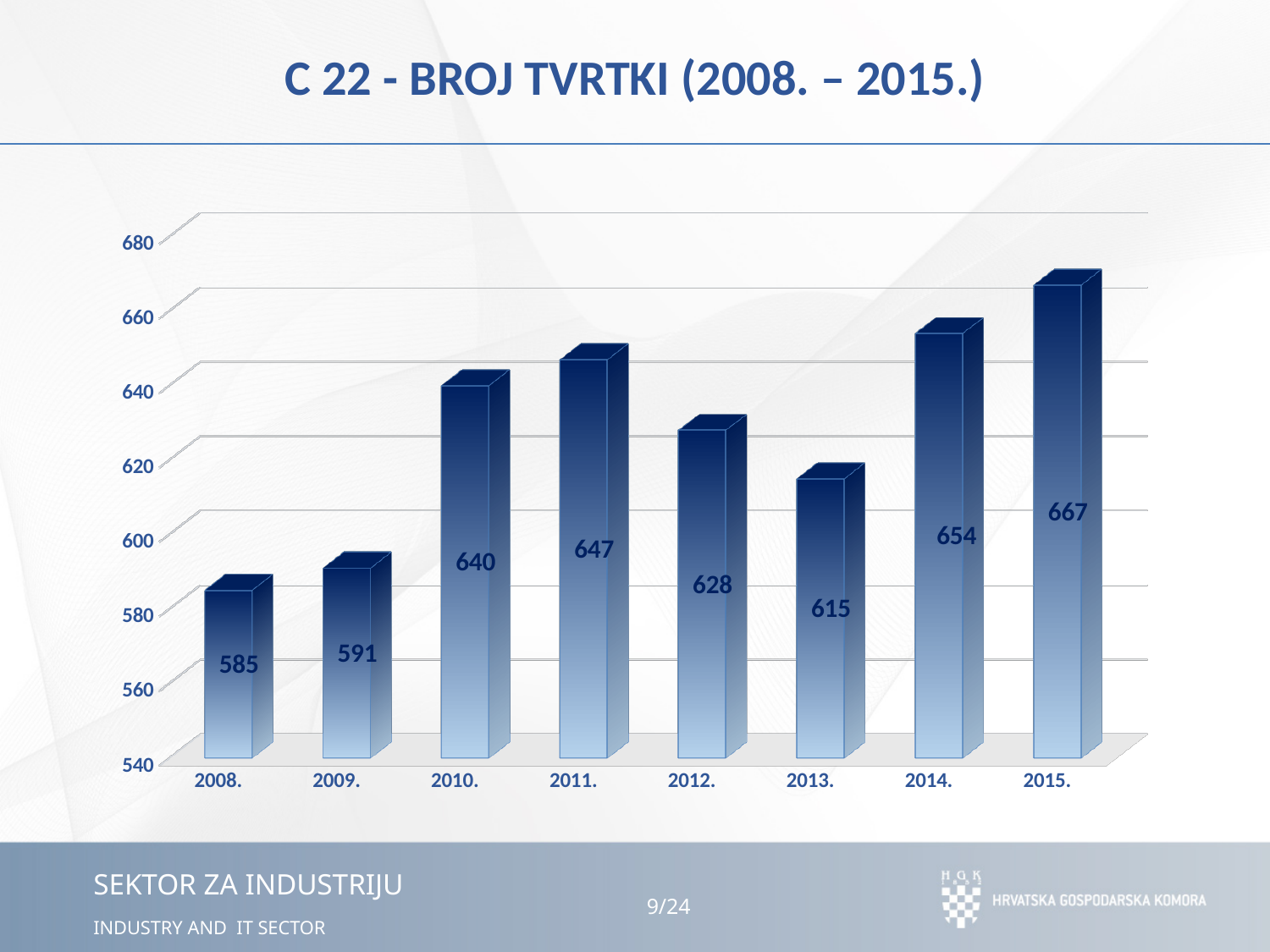
Is the value for 2009. greater or less than 600? less What kind of chart is shown on the slide? bar chart What is the value for 2013.? 615 What is the difference between the values for 2011. and 2012.? 19 Which year has the lowest value? 2008. Which year has the highest value? 2015. Do the values rise or fall from 2012. to 2013.? fall What is the value for 2010.? 640 Which is larger, the value for 2011. or the value for 2014.? 2014. What is the difference between the values for 2015. and 2008.? 82 How many years are shown on the x axis? 8 What is the title of the chart? C 22 - BROJ TVRTKI (2008. – 2015.)